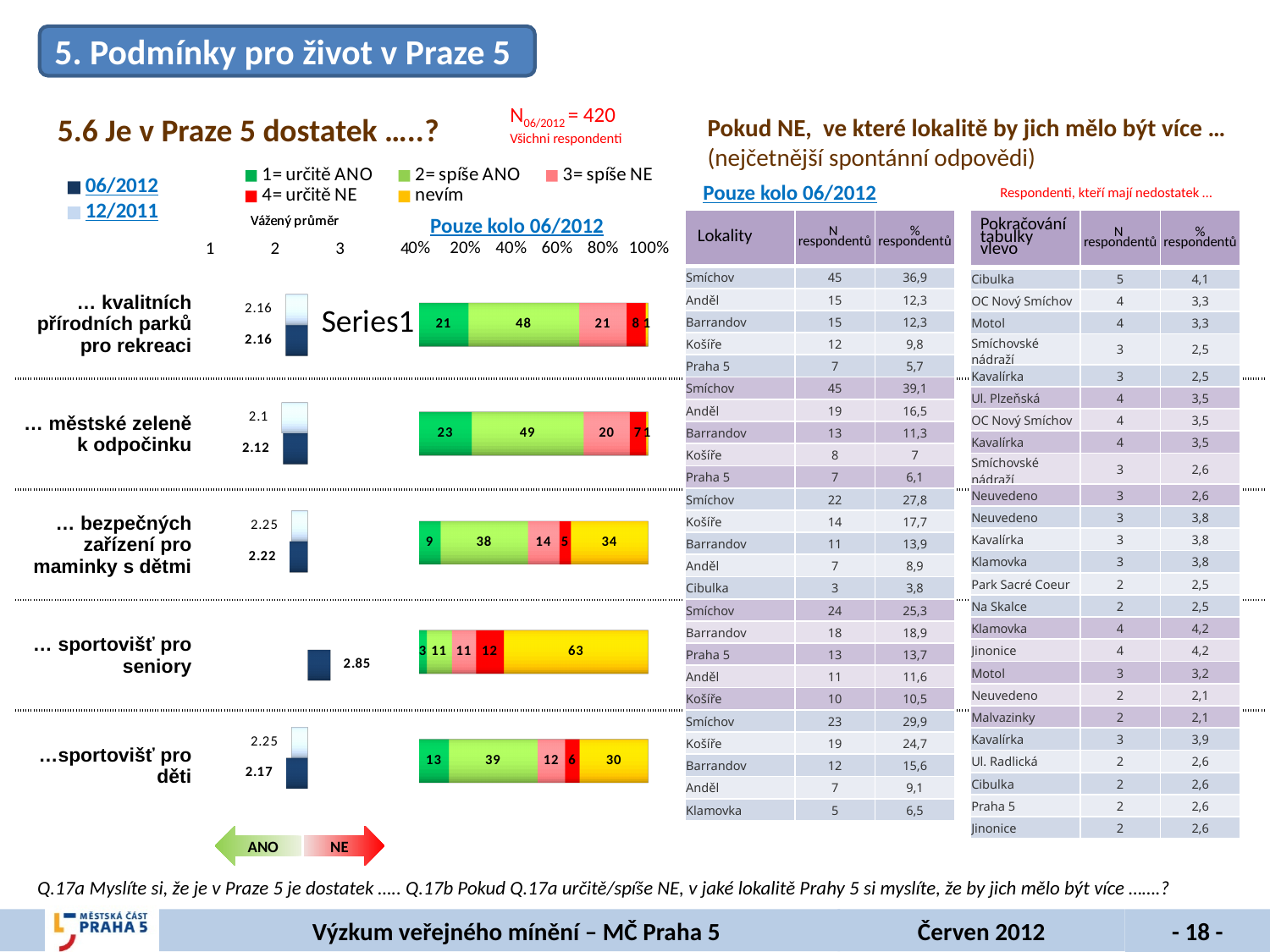
In the stacked bar chart, what percentage of respondents answered "1= určitě ANO" for "… kvalitních přírodních parků pro rekreaci"? 21 In the stacked bar chart, which is larger: the "4= určitě NE" value for "… sportovišť pro seniory" or for "…sportovišť pro děti"? … sportovišť pro seniory What type of chart is used to show the answer distribution for "Je v Praze 5 dostatek …?"? Stacked bar chart In the stacked bar chart, which category has the lowest "1= určitě ANO" value? … sportovišť pro seniory How many series does the legend of the stacked bar chart list? 5 In the "Vážený průměr" chart, what is the 06/2012 weighted average for "… sportovišť pro seniory"? 2.85 In the stacked bar chart, what is the "nevím" value for "… bezpečných zařízení pro maminky s dětmi"? 34 In the stacked bar chart, what is the "nevím" value for "… sportovišť pro seniory"? 63 In the stacked bar chart, which category has the highest "nevím" value? … sportovišť pro seniory How many categories (rows) are shown in the stacked bar chart? 5 In the stacked bar chart, what is the difference between the "2= spíše ANO" values for "… městské zeleně k odpočinku" and "…sportovišť pro děti"? 10 In the stacked bar chart, what is the "2= spíše ANO" value for "… městské zeleně k odpočinku"? 49